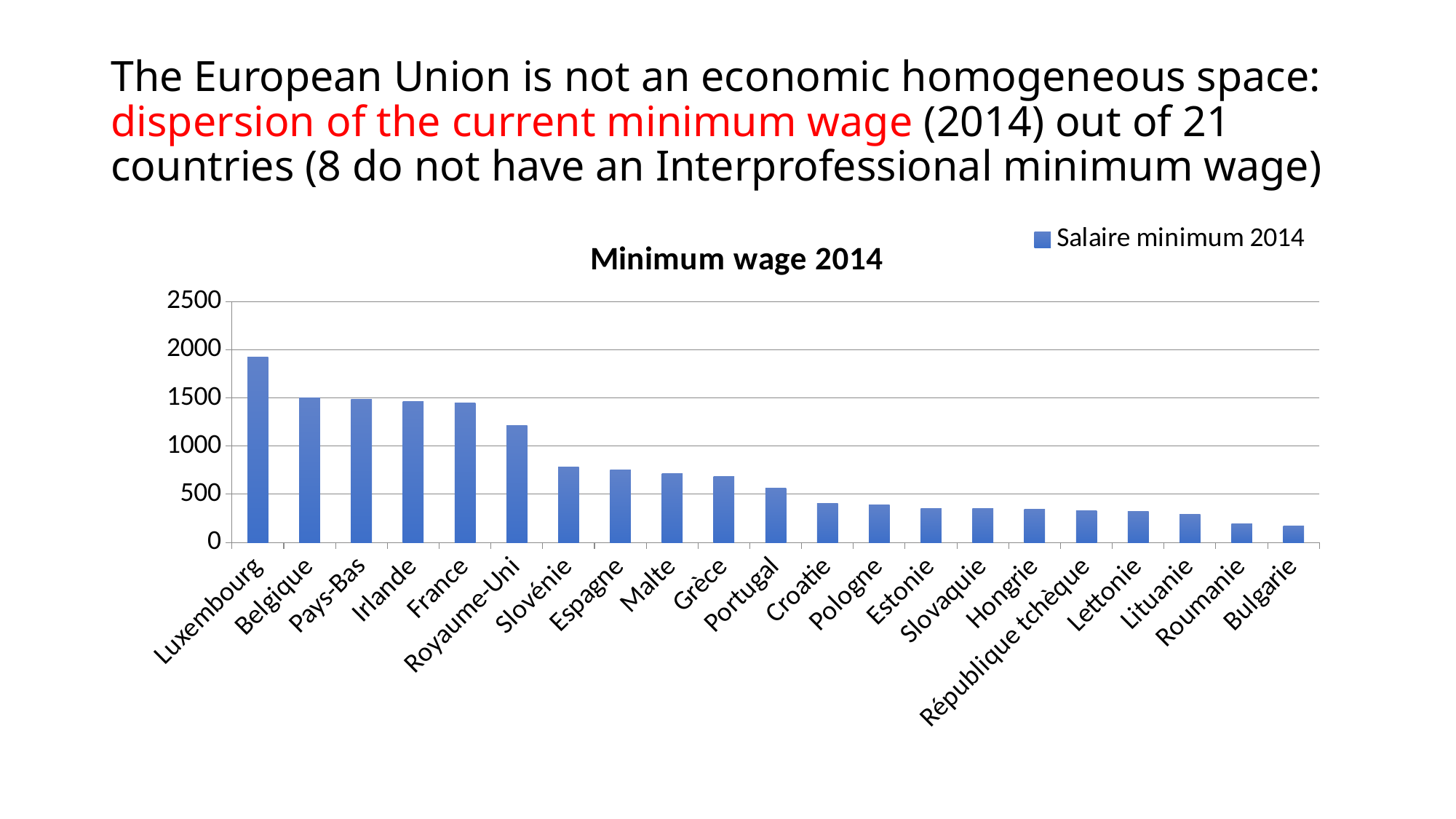
Is the value for Luxembourg greater or less than 1500? greater Is the value for Croatie greater or less than 500? less Which country has the lowest minimum wage in the chart? Bulgarie Which country has the highest minimum wage in the chart? Luxembourg How many countries are plotted in the chart? 21 How many series does the legend list? 1 What kind of chart is shown on the slide? bar chart Which is larger, the value for Royaume-Uni or the value for Slovénie? Royaume-Uni What is the title of the chart? Minimum wage 2014 Is the value for Slovénie greater or less than 1000? less Do the values rise or fall from left to right along the x axis? fall